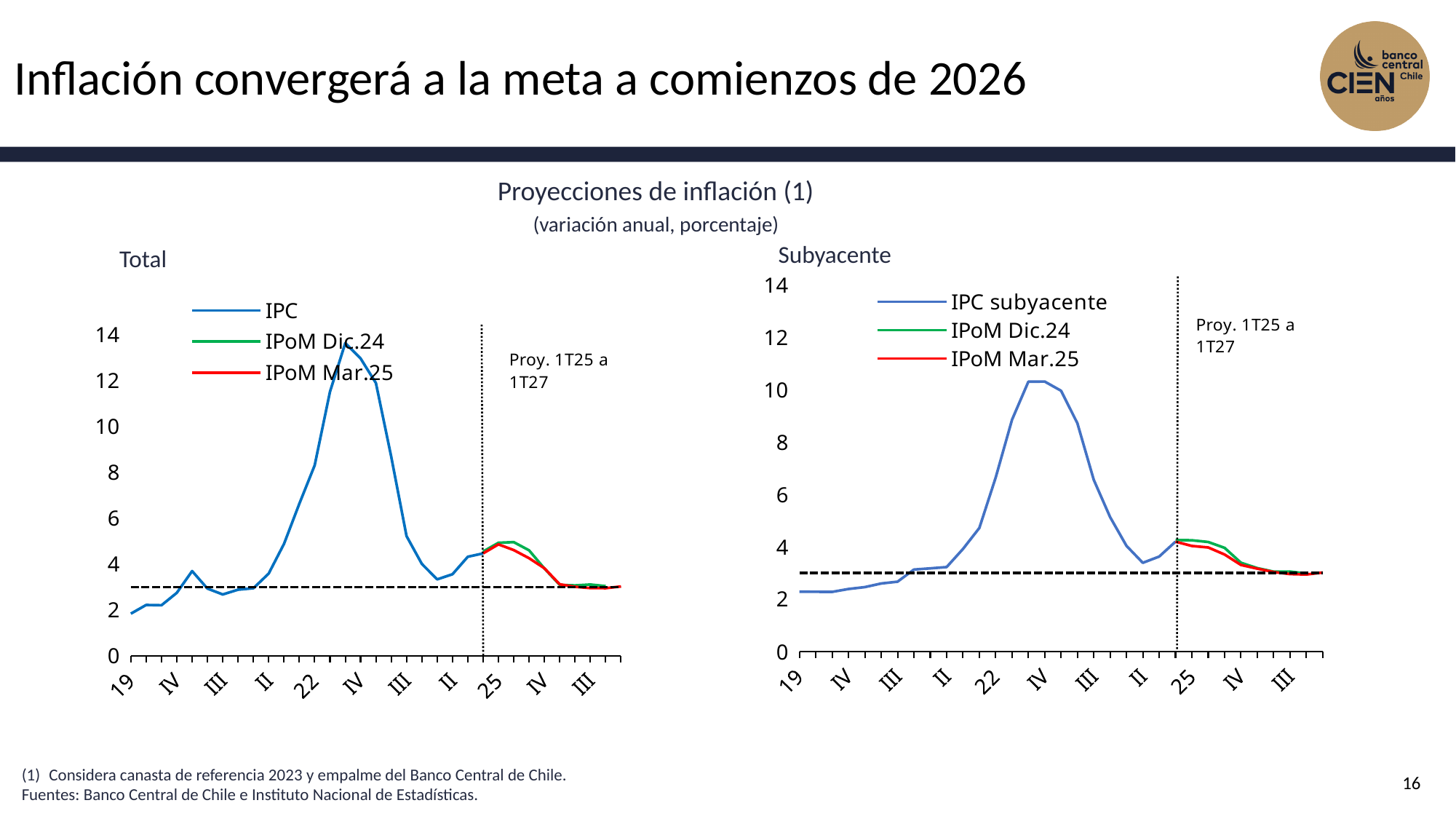
In the 'Total' chart, is the peak value of the IPC series greater or less than 12? greater In the 'Subyacente' chart, does the IPC subyacente series rise or fall between the x-axis labels 'IV' (after 22) and 'II'? fall In the 'Subyacente' chart, is the peak value of the IPC subyacente series greater or less than 8? greater What kind of chart is the 'Total' chart on the left? line chart In the 'Total' chart, is the IPC value at the first point (19) greater or less than 4? less What is the title of the 'Subyacente' chart's first legend entry? IPC subyacente In the 'Total' chart, does the IPC series rise or fall between the x-axis labels '22' and 'IV'? rise How many series does the legend of the 'Subyacente' chart list? 3 Which chart shows a higher peak for its blue series, 'Total' or 'Subyacente'? Total How many series does the legend of the 'Total' chart list? 3 In the 'Total' chart, which series is drawn in red according to the legend? IPoM Mar.25